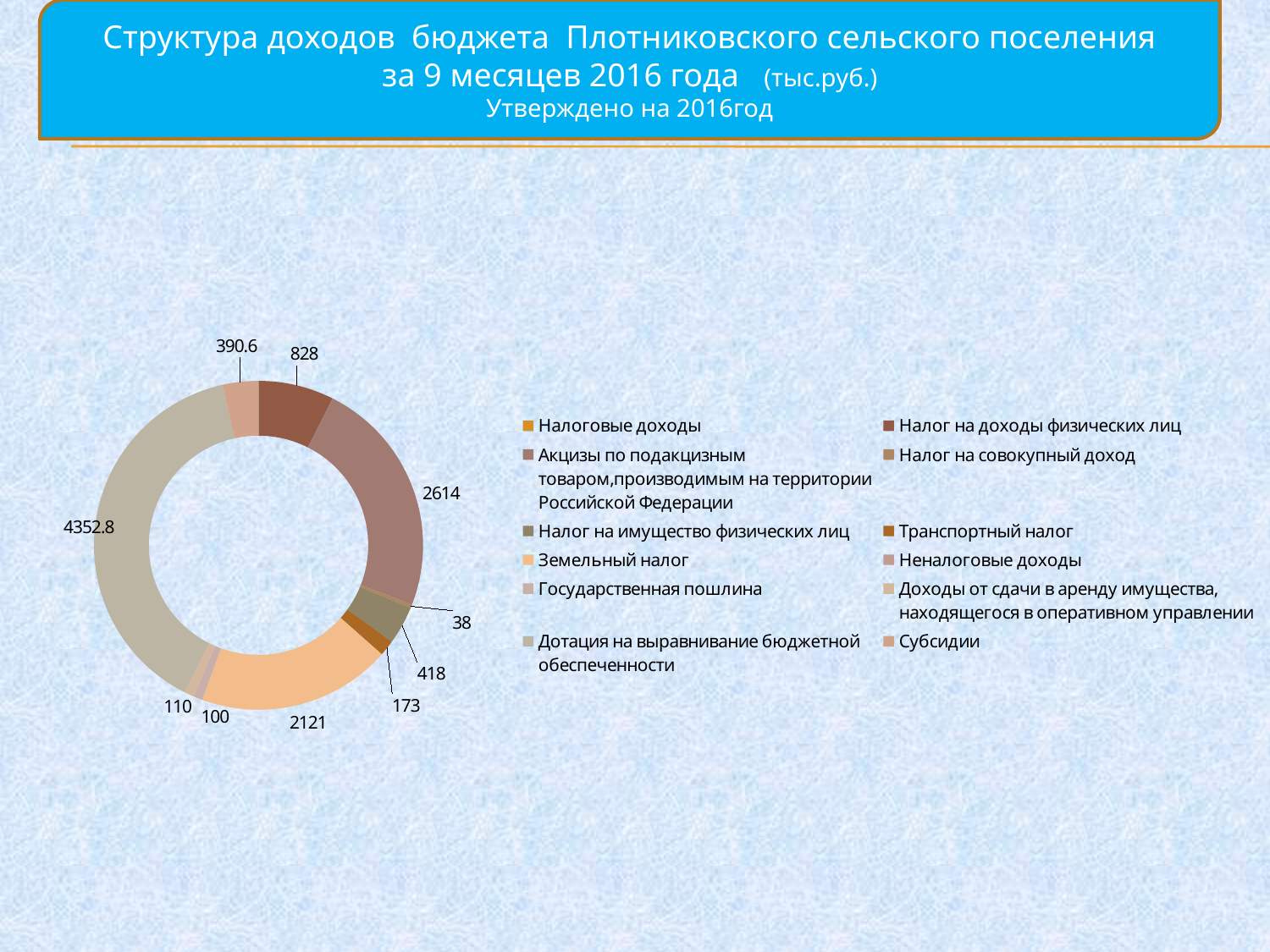
What is the largest value labelled on the chart? 4352.8 What kind of chart is shown on the slide? doughnut chart How many data labels are printed on the doughnut chart? 10 What is the difference between the slices labelled 418 and 173? 245 What is the value for Земельный налог? 2121 Which is larger, the slice labelled 828 or the slice labelled 390.6? 828 What is the value for Дотация на выравнивание бюджетной обеспеченности? 4352.8 What is the smallest value labelled on the chart? 38 What is the value for Налог на доходы физических лиц? 828 How many entries does the chart legend list? 12 What is the difference between the slices labelled 2614 and 2121? 493 What unit of measurement is stated in the slide title? тыс.руб.